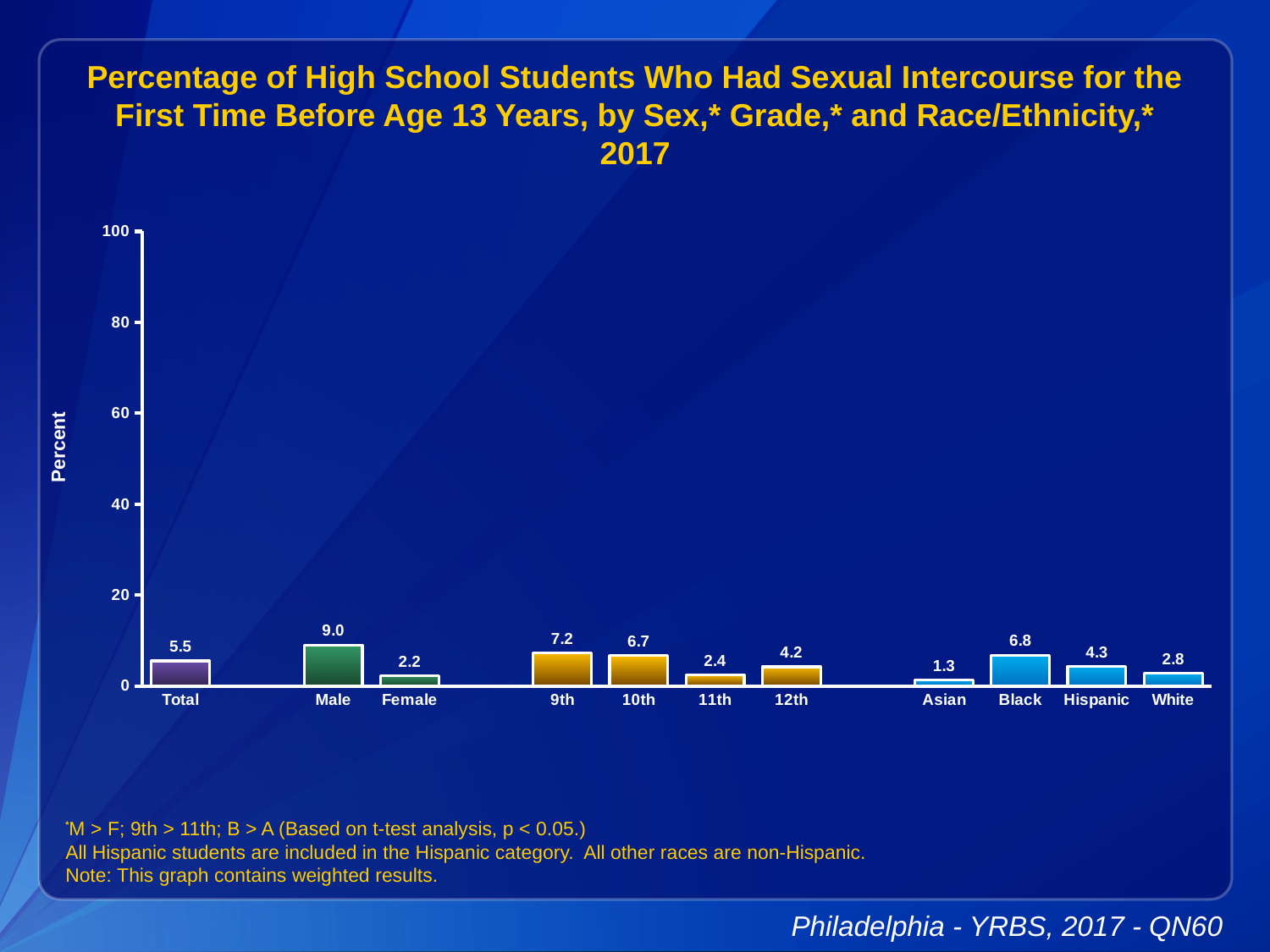
Which category has the lowest value? Asian Which category has the highest value? Male What is the value for Asian? 1.3 What is the value for Male? 9.0 What is the difference between the Black and Hispanic values? 2.5 What is the value for the Total bar? 5.5 How many bars are shown in the chart? 11 Is the value for Black greater or less than 20? less What kind of chart is this? bar chart Which is larger, the value for 9th or the value for 11th? 9th What is the difference between the Male and Female values? 6.8 What is the label on the y axis? Percent